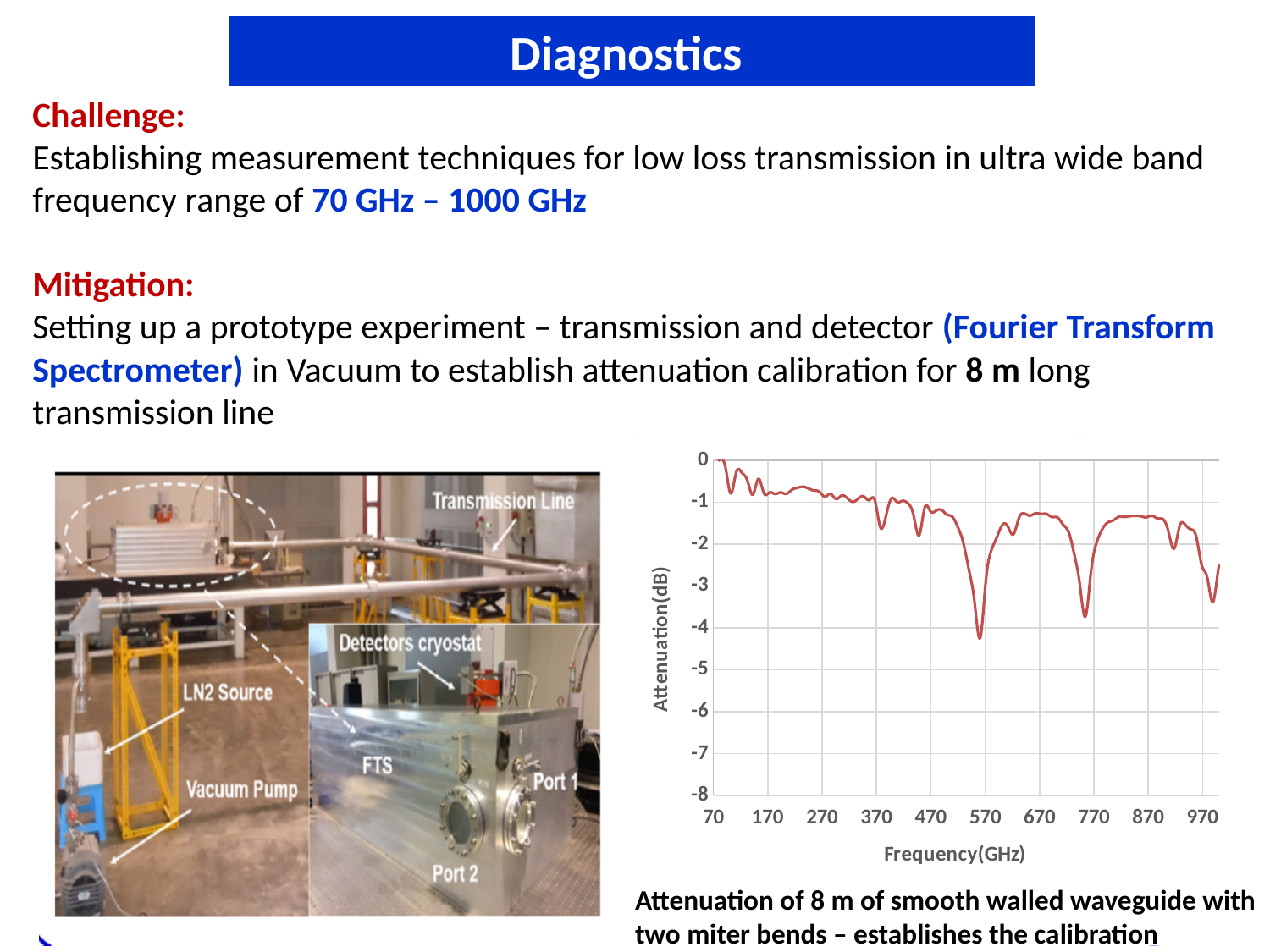
Is the attenuation at 970 GHz greater or less than -2 dB? less Overall, does the attenuation rise or fall as frequency increases from 70 GHz to 970 GHz? fall Is the attenuation at 70 GHz greater or less than -1 dB? greater What is the lowest value shown on the y-axis of the attenuation chart? -8 What is the label of the x-axis of the attenuation chart? Frequency(GHz) Which has the lower attenuation, 70 GHz or 970 GHz? 970 GHz What is the label of the y-axis of the attenuation chart? Attenuation(dB) Is the attenuation at 870 GHz greater or less than -2 dB? greater What kind of chart is shown on the right of the slide? Line chart